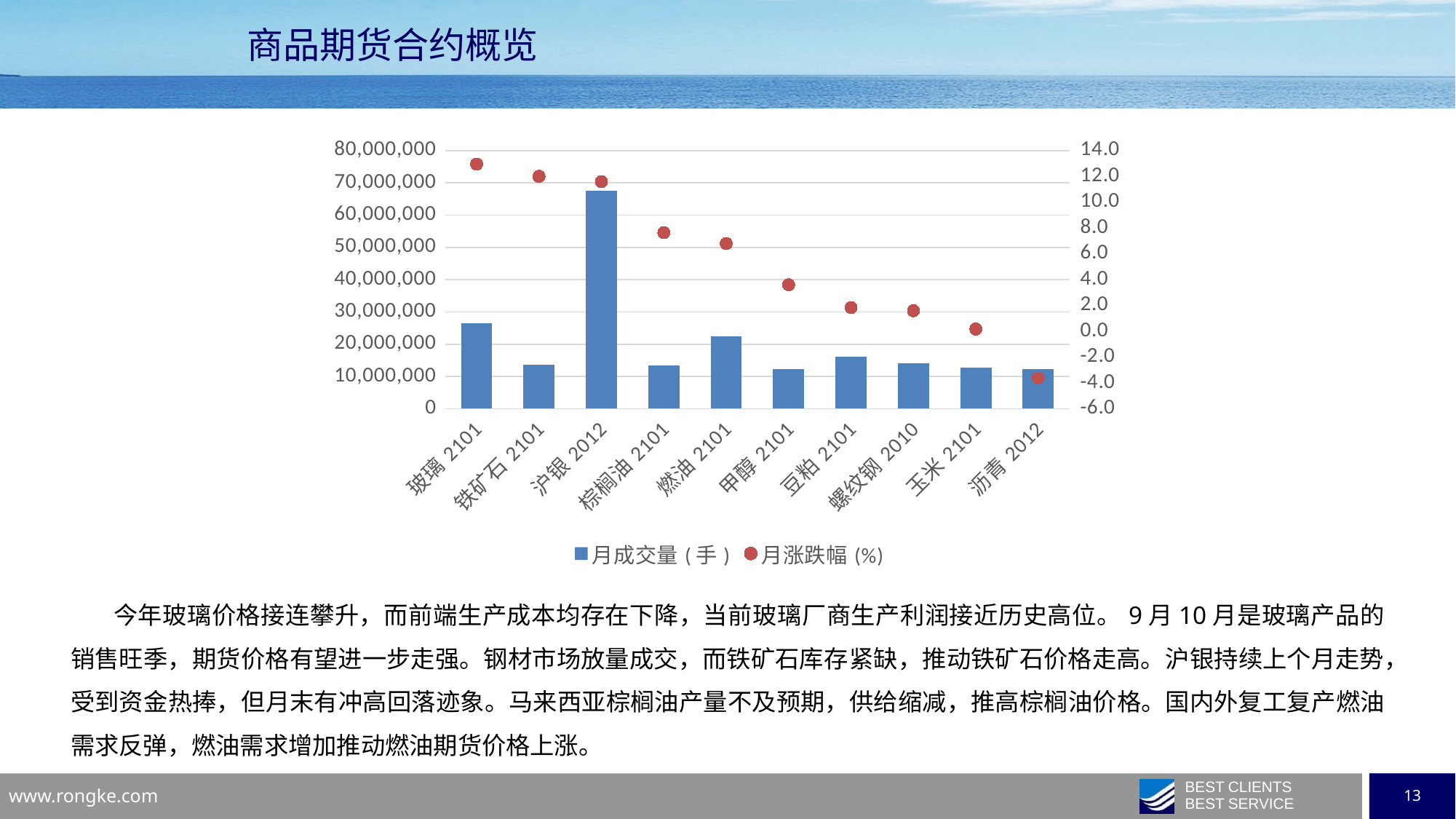
Which contract has the highest 月涨跌幅 (%)? 玻璃 2101 Which contract has the highest 月成交量（手）? 沪银 2012 What kind of chart is used to show 月成交量（手）? bar chart Is the 月涨跌幅 (%) for 沥青 2012 greater or less than 0.0? less How many series does the chart legend list? 2 What is the title of the slide containing the chart? 商品期货合约概览 Is the 月成交量（手） for 沪银 2012 greater or less than 60,000,000? greater Which contract has the lowest 月涨跌幅 (%)? 沥青 2012 Which has the larger 月成交量（手）, 玻璃 2101 or 铁矿石 2101? 玻璃 2101 Do the 月涨跌幅 (%) values generally rise or fall moving from left to right along the x axis? fall How many contracts (categories) are shown on the x axis of the chart? 10 What are the two series named in the chart legend? 月成交量（手） and 月涨跌幅 (%)